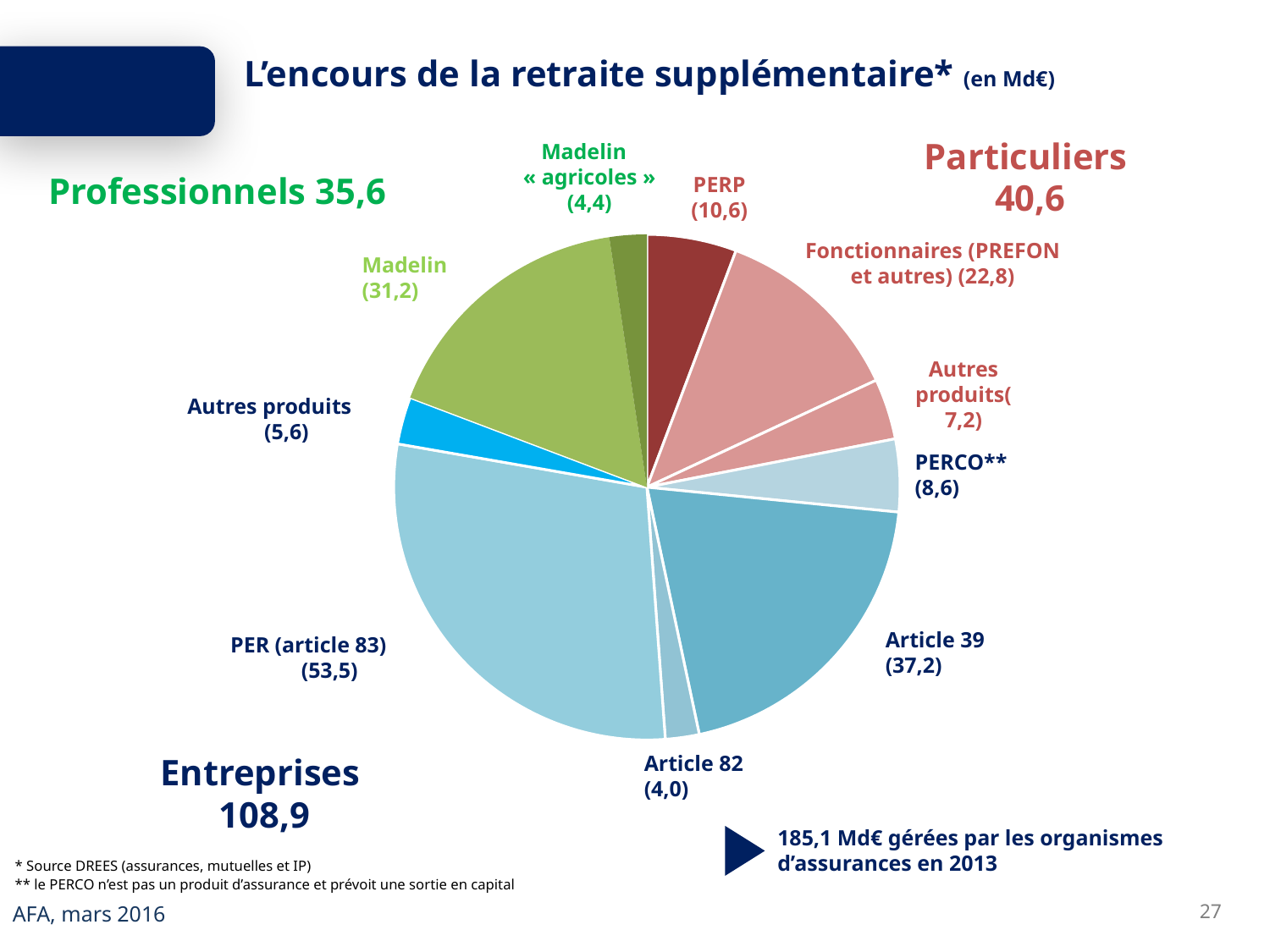
What is the value for PERCO**? 8,6 What is the difference between PER (article 83) and Article 39? 16,3 What kind of chart is shown on the slide? pie chart Which slice of the pie is the smallest? Article 82 What is the value for Madelin « agricoles »? 4,4 Which is larger, Madelin or Fonctionnaires (PREFON et autres)? Madelin Which slice of the pie is the largest? PER (article 83) What is the value for Fonctionnaires (PREFON et autres)? 22,8 What is the value for PER (article 83)? 53,5 How many slices does the pie chart have? 10 What is the title of the chart? L'encours de la retraite supplémentaire* (en Md€) What is the total for the Entreprises group shown on the slide? 108,9